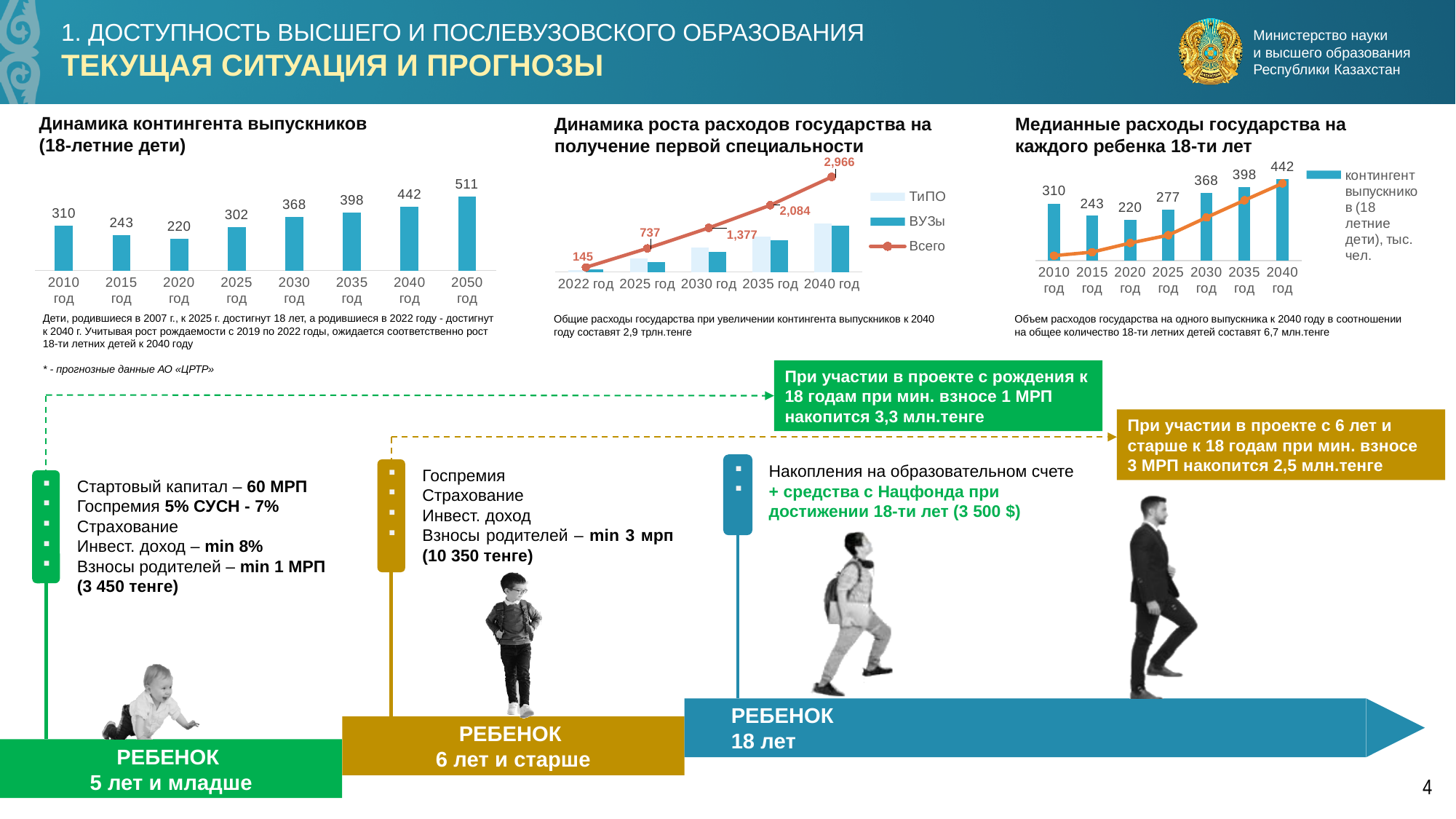
In the chart 'Динамика контингента выпускников (18-летние дети)', which year has the lowest value? 2020 год What type of chart is 'Динамика контингента выпускников (18-летние дети)'? bar chart In the chart 'Динамика роста расходов государства на получение первой специальности', does the 'Всего' line rise or fall from 2022 год to 2040 год? rise In the chart 'Динамика роста расходов государства на получение первой специальности', what is the value of the 'Всего' line for 2040 год? 2,966 In the chart 'Динамика роста расходов государства на получение первой специальности', what is the difference between the 'Всего' values for 2035 год and 2030 год? 707 In the chart 'Медианные расходы государства на каждого ребенка 18-ти лет', what is the value for 2025 год? 277 In the chart 'Медианные расходы государства на каждого ребенка 18-ти лет', which year has the highest value? 2040 год In the chart 'Динамика контингента выпускников (18-летние дети)', which is larger: the value for 2015 год or 2025 год? 2025 год In the chart 'Динамика контингента выпускников (18-летние дети)', what is the value for 2050 год? 511 In the chart 'Динамика контингента выпускников (18-летние дети)', what is the difference between the values for 2050 год and 2010 год? 201 In the chart 'Динамика контингента выпускников (18-летние дети)', how many years are shown on the x axis? 8 In the chart 'Динамика роста расходов государства на получение первой специальности', how many series does the legend list? 3